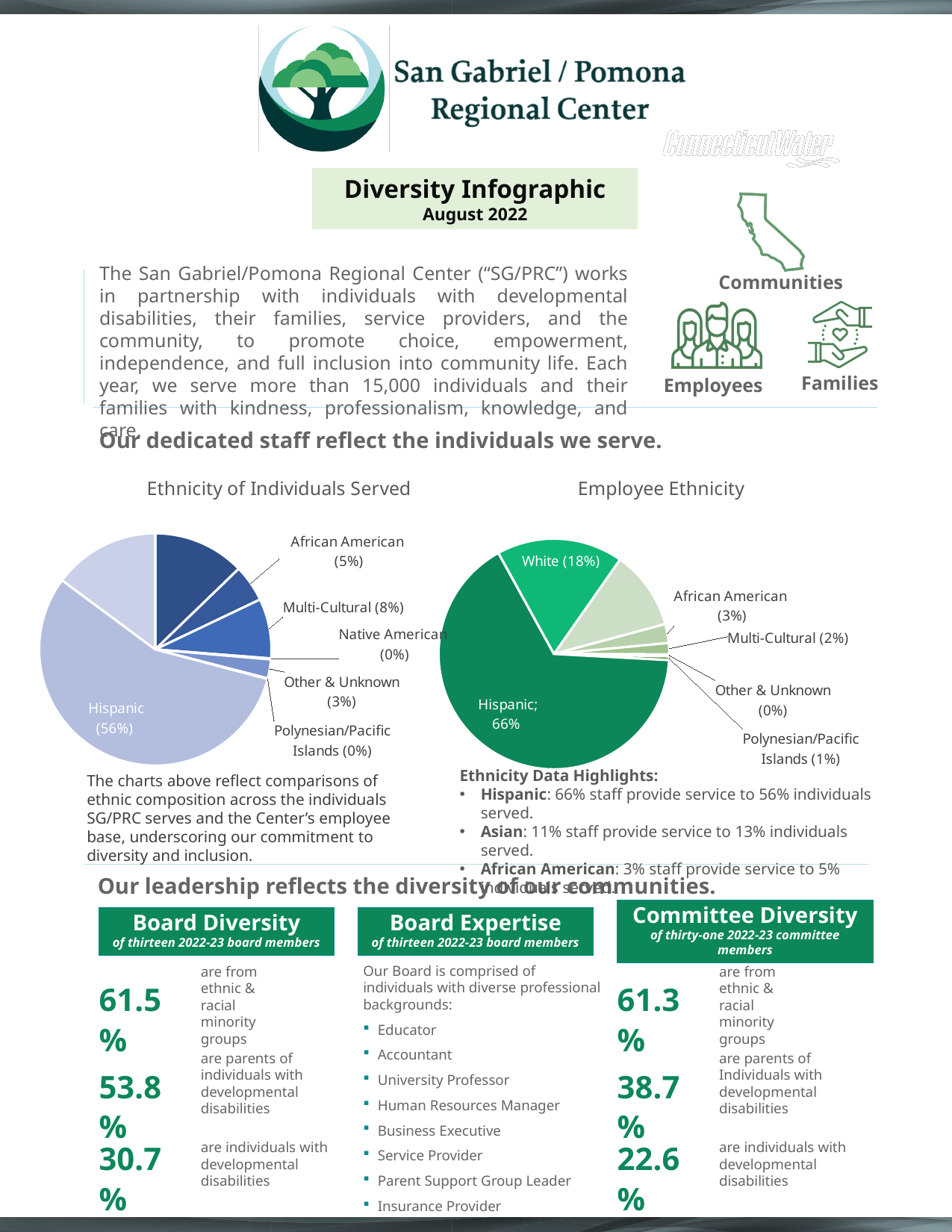
In the Ethnicity of Individuals Served chart, which ethnicity has the largest share? Hispanic In the Employee Ethnicity chart, which is larger: African American or Multi-Cultural? African American In the Employee Ethnicity chart, what percentage is White? 18% What is the difference between the Hispanic share in the Employee Ethnicity chart and the Hispanic share in the Ethnicity of Individuals Served chart? 10% In the Employee Ethnicity chart, what percentage is Hispanic? 66% In the Ethnicity of Individuals Served chart, what percentage is Hispanic? 56% In the Ethnicity of Individuals Served chart, what percentage is Multi-Cultural? 8% In the Ethnicity of Individuals Served chart, what percentage is Other & Unknown? 3% In the Ethnicity of Individuals Served chart, what percentage is African American? 5% In the Employee Ethnicity chart, what percentage is Polynesian/Pacific Islands? 1% In the Employee Ethnicity chart, which ethnicity has the largest share? Hispanic What type of chart is the Employee Ethnicity chart? Pie chart